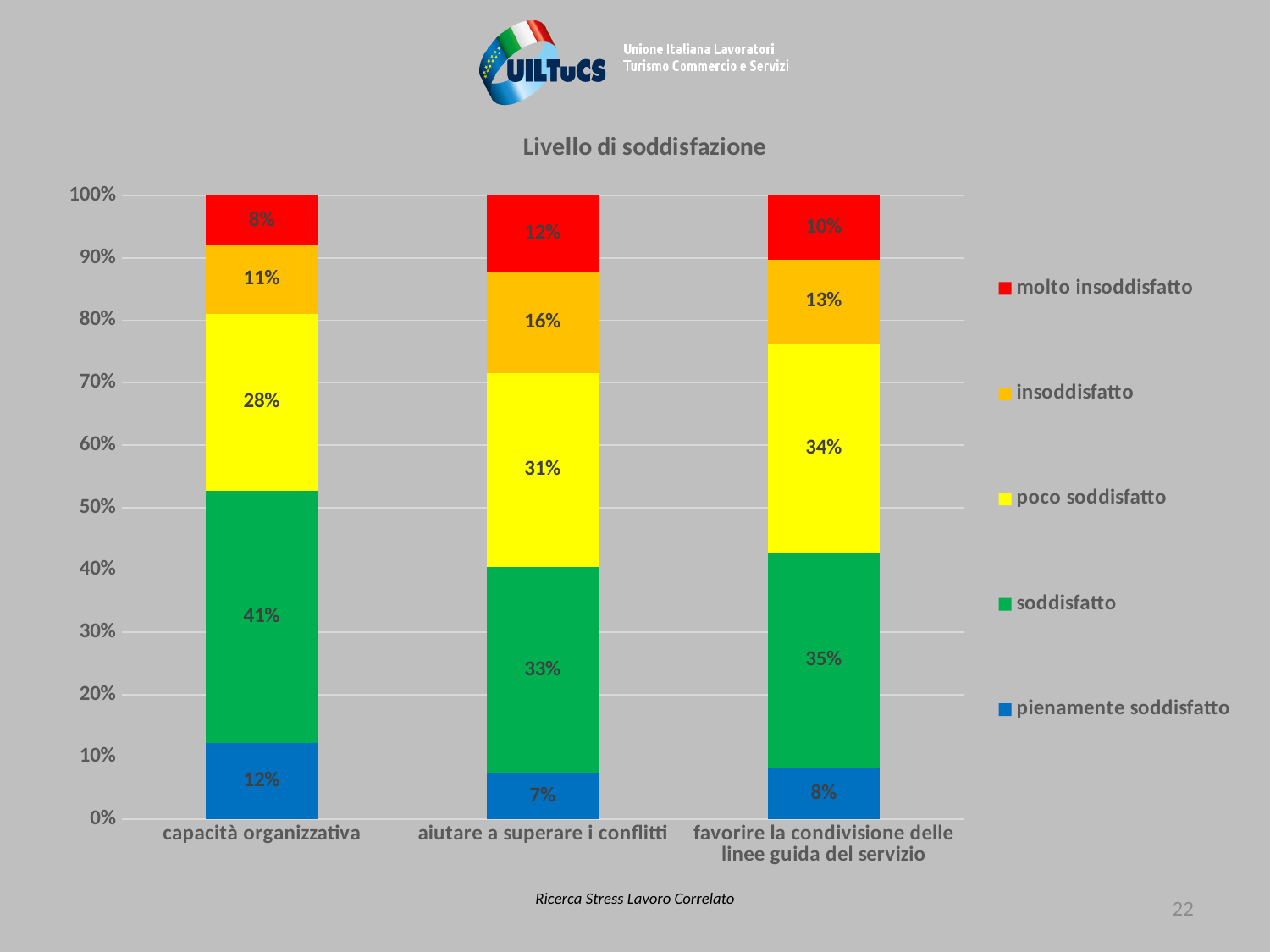
Which category has the lowest value for 'insoddisfatto'? capacità organizzativa What is the value for 'poco soddisfatto' in the 'favorire la condivisione delle linee guida del servizio' bar? 34% Which is larger: 'insoddisfatto' for 'aiutare a superare i conflitti' or 'insoddisfatto' for 'favorire la condivisione delle linee guida del servizio'? aiutare a superare i conflitti What is the value for 'molto insoddisfatto' in the 'aiutare a superare i conflitti' bar? 12% What is the difference between the 'soddisfatto' values for 'capacità organizzativa' and 'aiutare a superare i conflitti'? 8% What kind of chart is shown on the slide? stacked bar chart What is the total of the 'capacità organizzativa' stacked bar? 100% What is the title of the chart? Livello di soddisfazione How many categories are shown on the x axis? 3 What is the value for 'soddisfatto' in the 'capacità organizzativa' bar? 41% Which category has the highest value for 'pienamente soddisfatto'? capacità organizzativa How many series does the legend list? 5